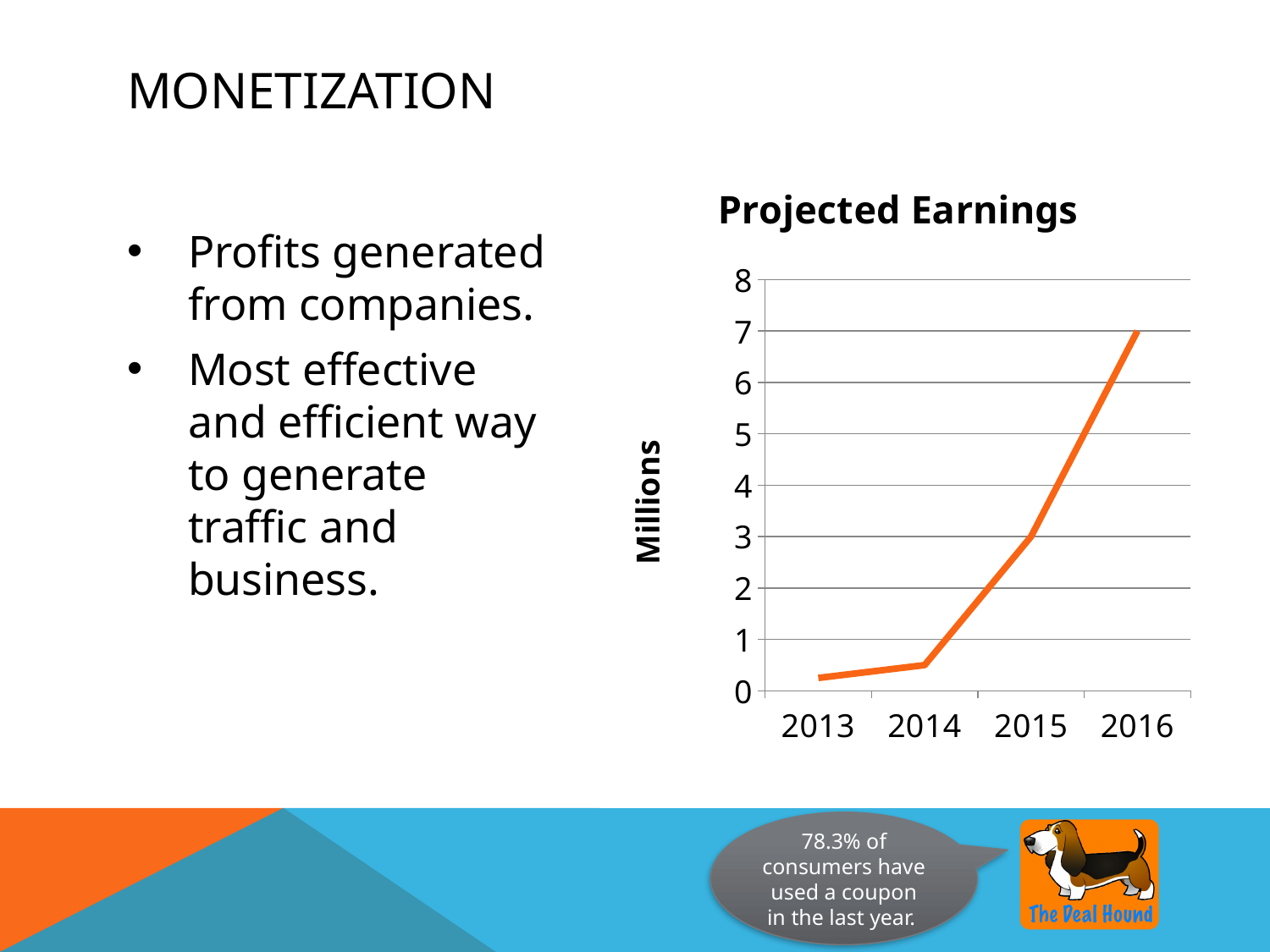
Do projected earnings rise or fall from 2013 to 2016? rise Is the value for 2014 greater or less than 1? less Which year has larger projected earnings, 2014 or 2015? 2015 Is the value for 2013 greater or less than 1? less What is the label on the vertical axis of the chart? Millions What kind of chart is shown on the slide? line chart Is the value for 2016 greater or less than 6? greater Which year has the highest projected earnings? 2016 Which year has the lowest projected earnings? 2013 How many years are plotted on the x axis of the chart? 4 What is the title of the chart? Projected Earnings